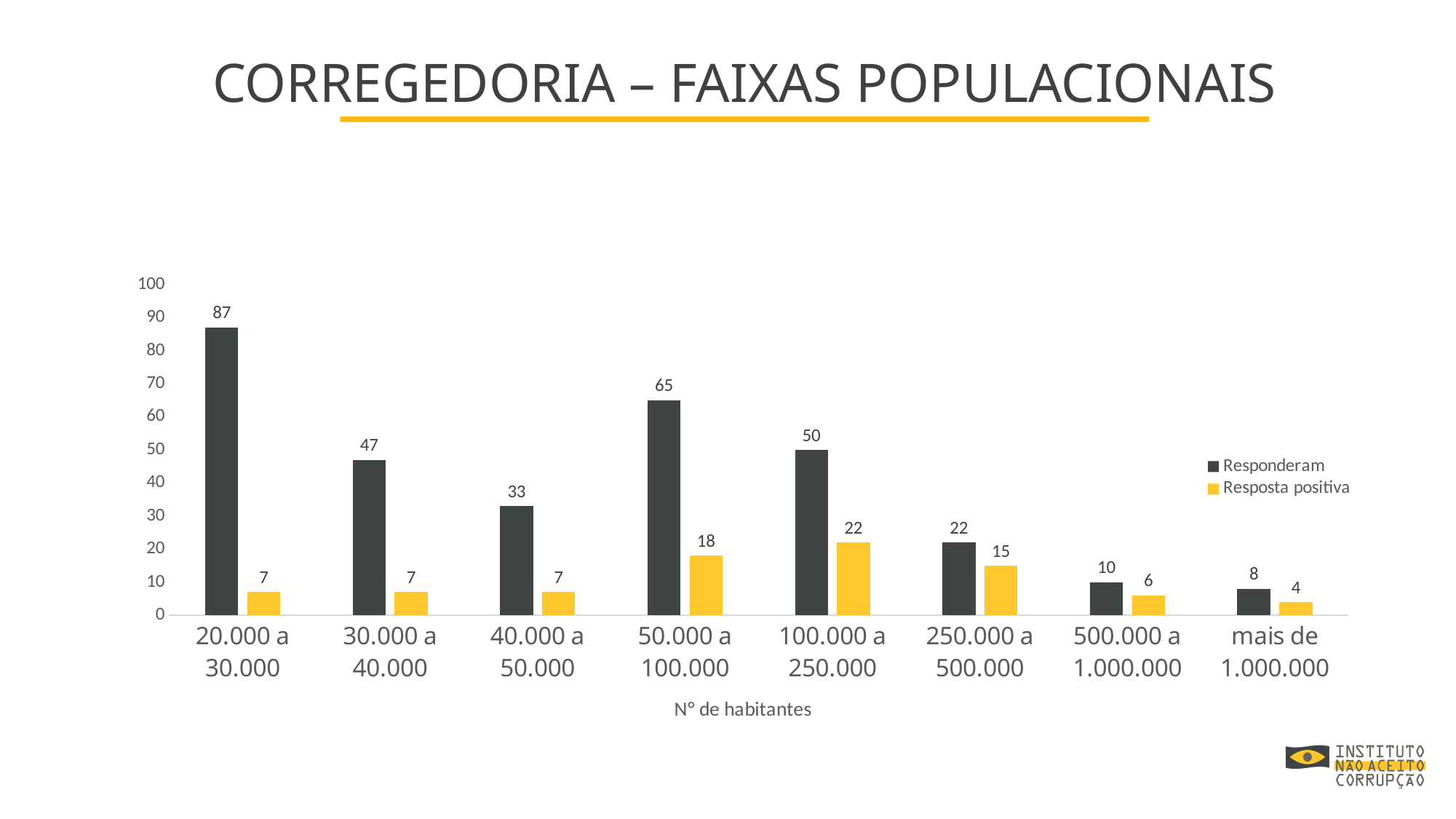
What is the label of the x axis? N° de habitantes Which is larger: Responderam for 30.000 a 40.000 or Responderam for 100.000 a 250.000? 100.000 a 250.000 Which category has the lowest Resposta positiva value? mais de 1.000.000 What is the difference between Responderam and Resposta positiva for the 50.000 a 100.000 category? 47 What is the title of the slide? CORREGEDORIA – FAIXAS POPULACIONAIS What is the value of Resposta positiva for the 100.000 a 250.000 category? 22 How many series does the legend list? 2 What is the value of Responderam for the 20.000 a 30.000 category? 87 What is the value of Responderam for the mais de 1.000.000 category? 8 How many population categories are shown on the x axis? 8 What kind of chart is shown on the slide? bar chart Which category has the highest Responderam value? 20.000 a 30.000